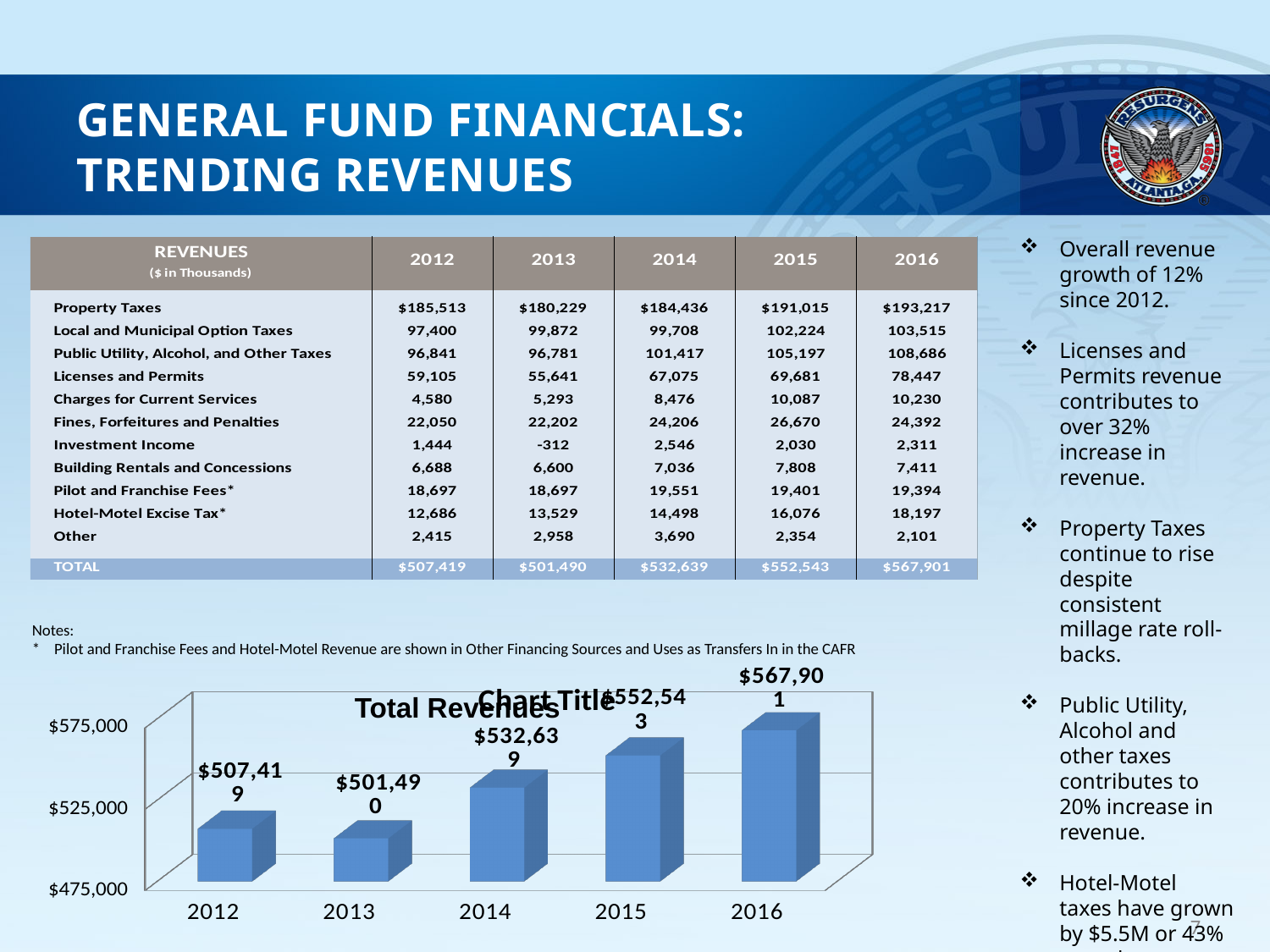
In the Total Revenues chart, do the values rise or fall from 2013 to 2016? rise Which year has the lowest total revenue in the Total Revenues chart? 2013 What is the value for 2012 in the Total Revenues chart? $507,419 How many years are shown on the x axis of the Total Revenues chart? 5 In the Total Revenues chart, is the value for 2013 greater or less than $525,000? less What is the value for 2016 in the Total Revenues chart? $567,901 In the Total Revenues chart, what is the difference between the 2016 and 2012 values? $60,482 What is the value for 2014 in the Total Revenues chart? $532,639 Which year has the highest total revenue in the Total Revenues chart? 2016 In the Total Revenues chart, which is larger, the value for 2013 or the value for 2014? 2014 What kind of chart is the Total Revenues chart? bar chart In the Total Revenues chart, what is the difference between the 2015 and 2014 values? $19,904